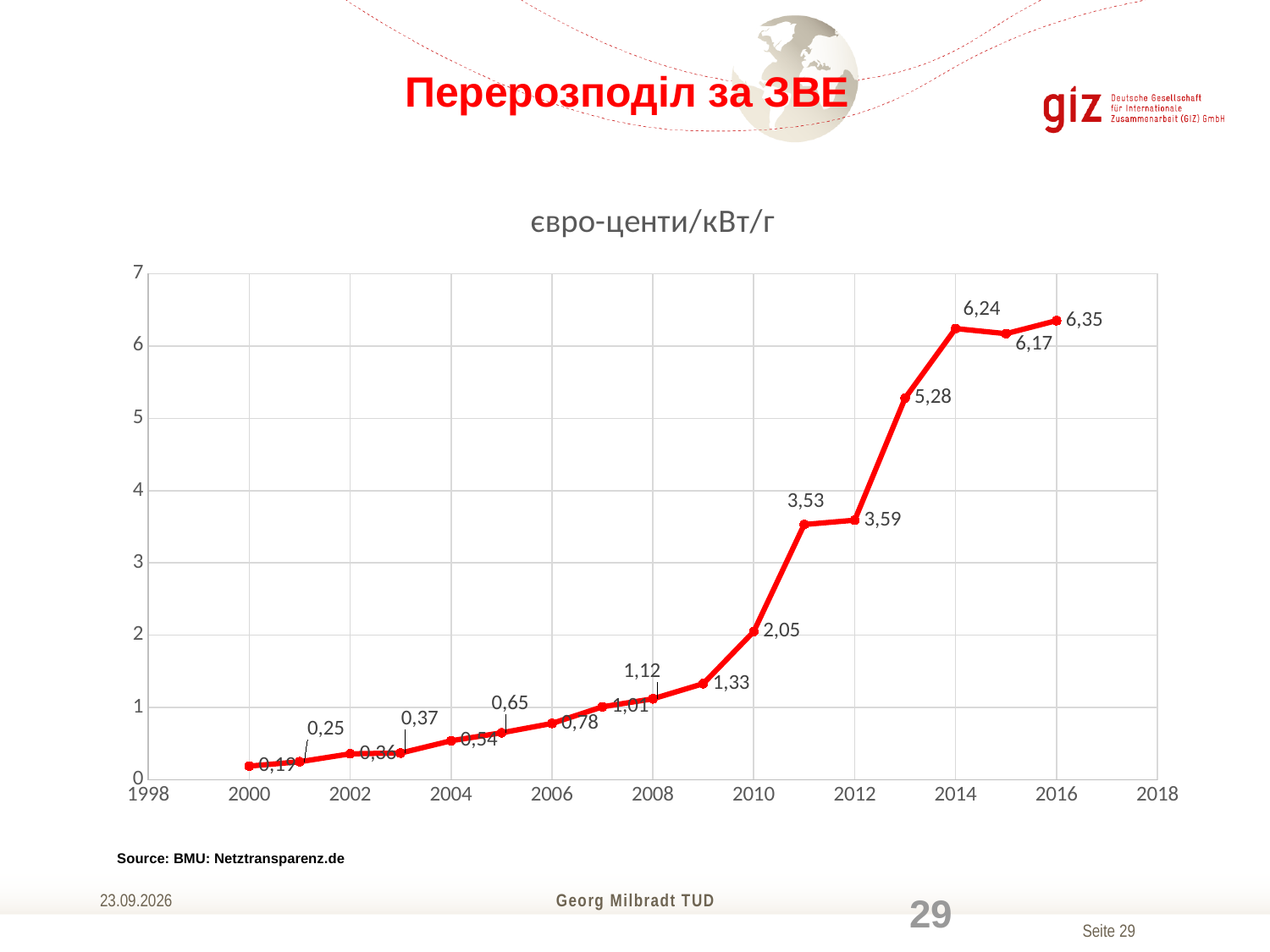
Do the values generally rise or fall from 2000 to 2016? rise What is the title of the chart? євро-центи/кВт/г What is the value for 2016? 6,35 What is the difference between the values for 2014 and 2015? 0,07 What is the difference between the values for 2011 and 2010? 1,48 Is the value for 2012 greater or less than 3? greater Which is larger, the value for 2014 or the value for 2015? 2014 What is the value for 2010? 2,05 What is the value for 2013? 5,28 What is the value for 2005? 0,65 Which year has the highest value? 2016 What kind of chart is shown on the slide? line chart